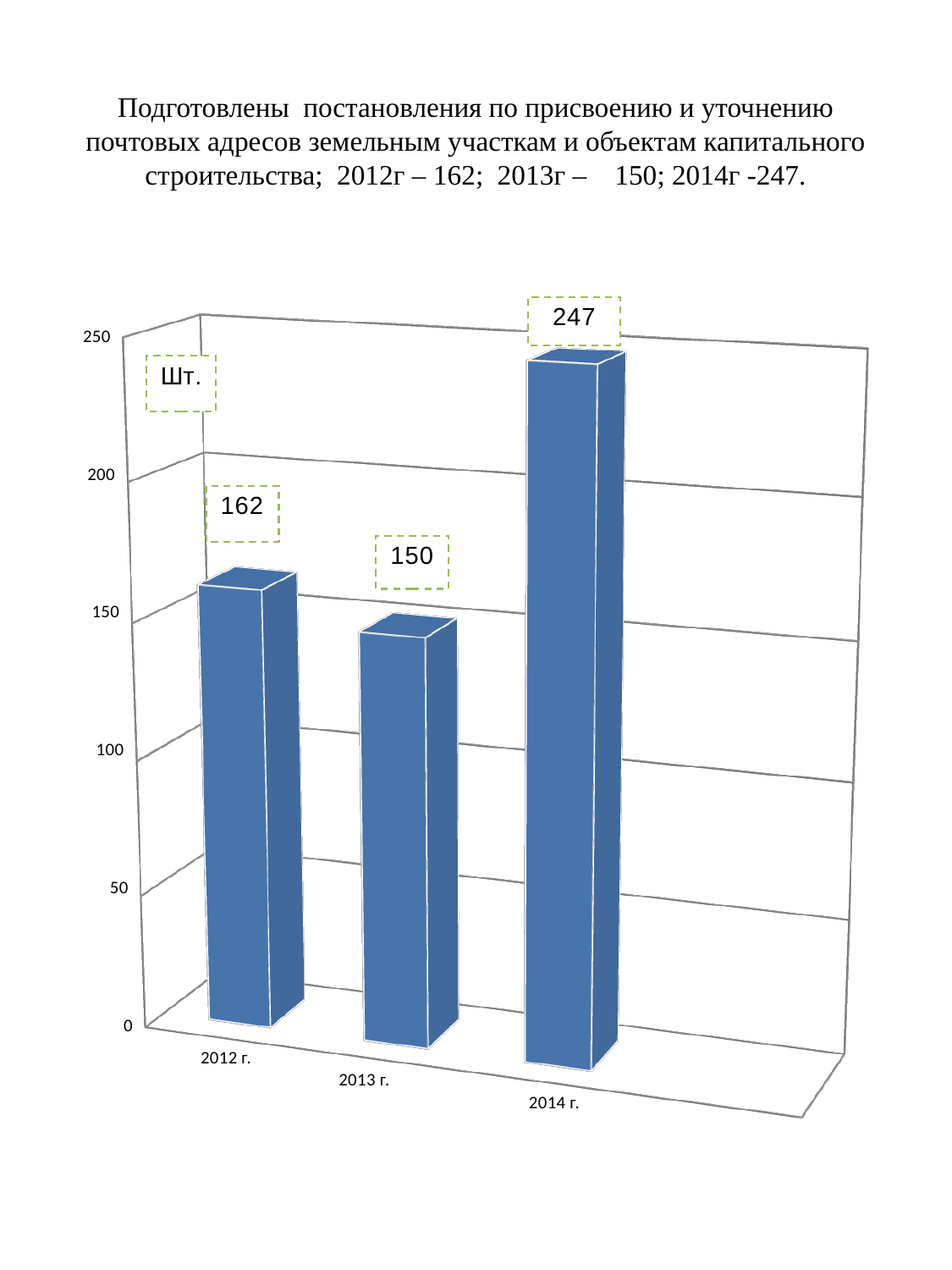
What kind of chart is shown on the slide? bar chart Is the value for 2014 г. greater or less than 200? greater Which is larger, the value for 2012 г. or the value for 2013 г.? 2012 г. What is the value for 2014 г.? 247 What is the difference between the values for 2012 г. and 2013 г.? 12 Which year has the highest value? 2014 г. What is the value for 2012 г.? 162 What is the difference between the values for 2014 г. and 2013 г.? 97 Which year has the lowest value? 2013 г. What unit label is shown in the box at the top left of the chart? Шт. How many years are shown on the chart? 3 What is the value for 2013 г.? 150